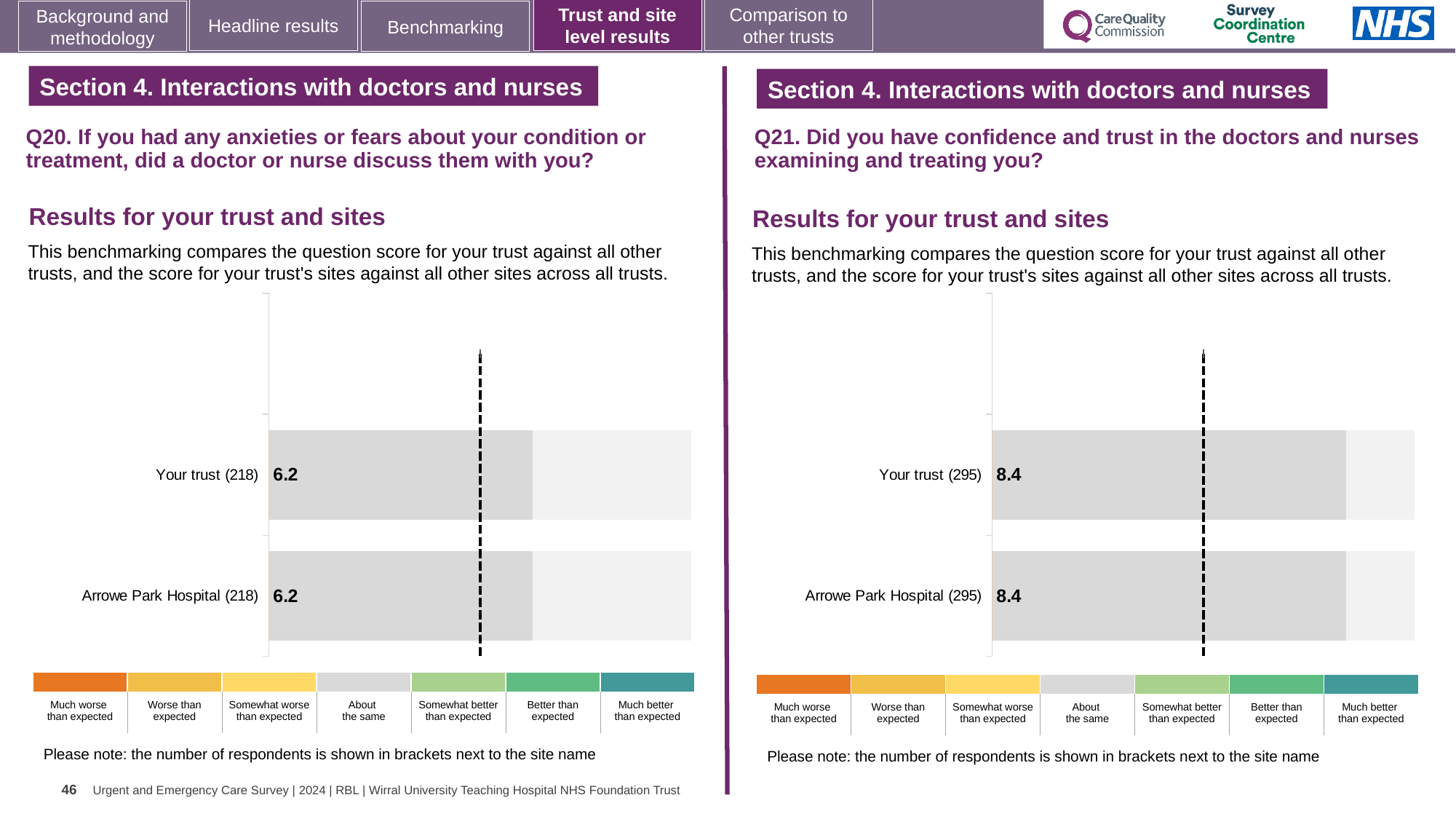
What kind of chart is used for the Q21 results on the right? Bar chart In the Q21 chart on the right, what is the difference between the score for Your trust and the score for Arrowe Park Hospital? 0 In the Q21 chart on the right, how many respondents are shown in brackets next to Your trust? 295 In the Q20 chart on the left, how many respondents are shown in brackets next to Arrowe Park Hospital? 218 In the Q21 chart on the right, what is the score for Arrowe Park Hospital? 8.4 Is the score for Your trust higher in the Q20 chart on the left or in the Q21 chart on the right? Q21 chart on the right In the Q20 chart on the left, what is the score for Your trust? 6.2 In the Q21 chart on the right, what is the score for Your trust? 8.4 How many bars are plotted in the Q21 chart on the right? 2 In the Q20 chart on the left, what is the difference between the score for Your trust and the score for Arrowe Park Hospital? 0 In the Q20 chart on the left, what is the score for Arrowe Park Hospital? 6.2 How many bars are plotted in the Q20 chart on the left? 2